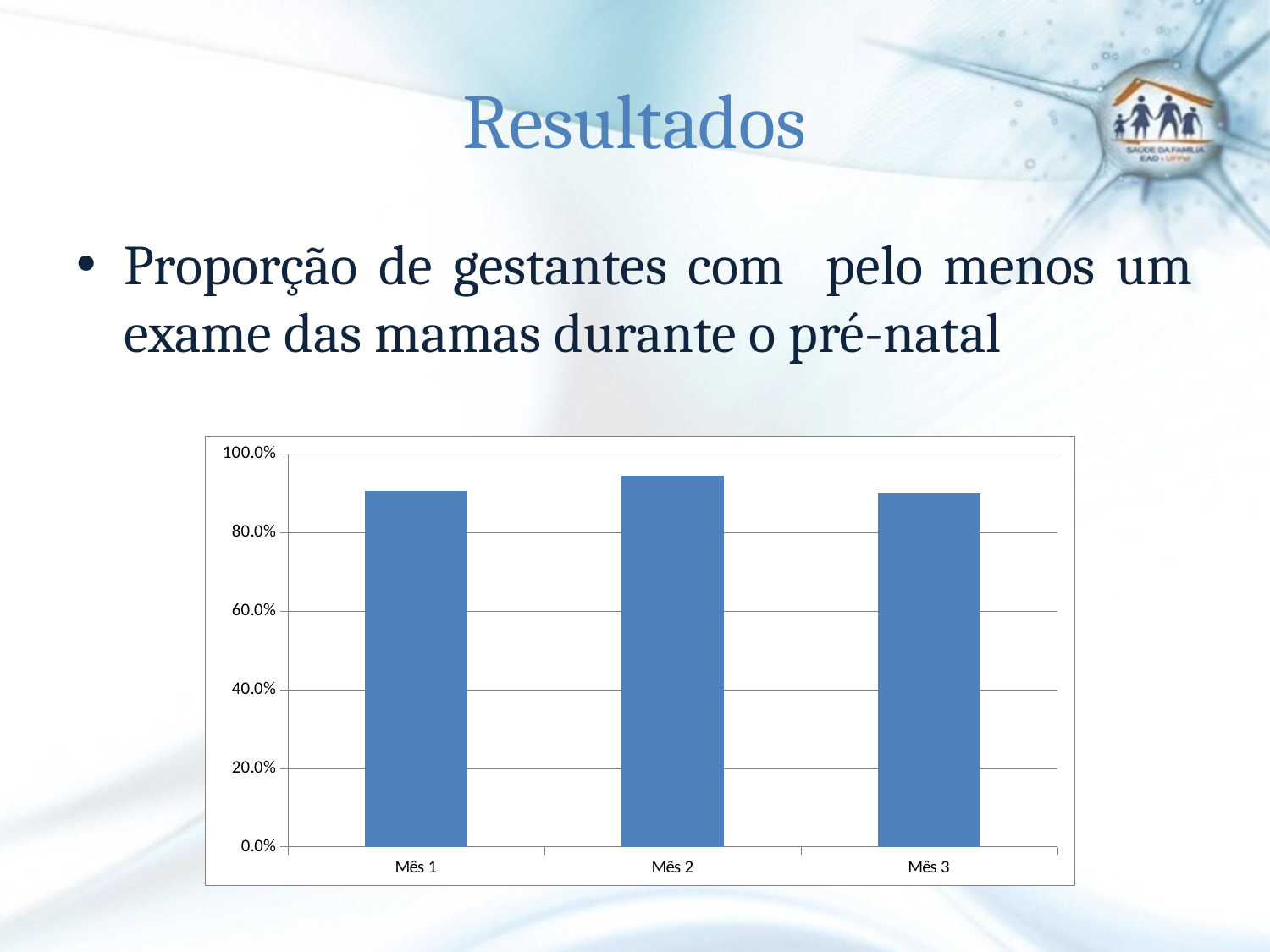
How many categories (months) are plotted in the chart? 3 Which is larger, the value for Mês 2 or the value for Mês 1? Mês 2 Does the value rise or fall from Mês 2 to Mês 3? fall Which month has the highest value in the chart? Mês 2 Which is larger, the value for Mês 2 or the value for Mês 3? Mês 2 Is the value for Mês 2 greater or less than 100.0%? less Does the value rise or fall from Mês 1 to Mês 2? rise What is the highest tick label shown on the vertical axis of the chart? 100.0% Is the value for Mês 1 greater or less than 80.0%? greater What kind of chart is shown on the slide? bar chart What colour are the bars in the chart? blue Is the value for Mês 3 greater or less than 80.0%? greater